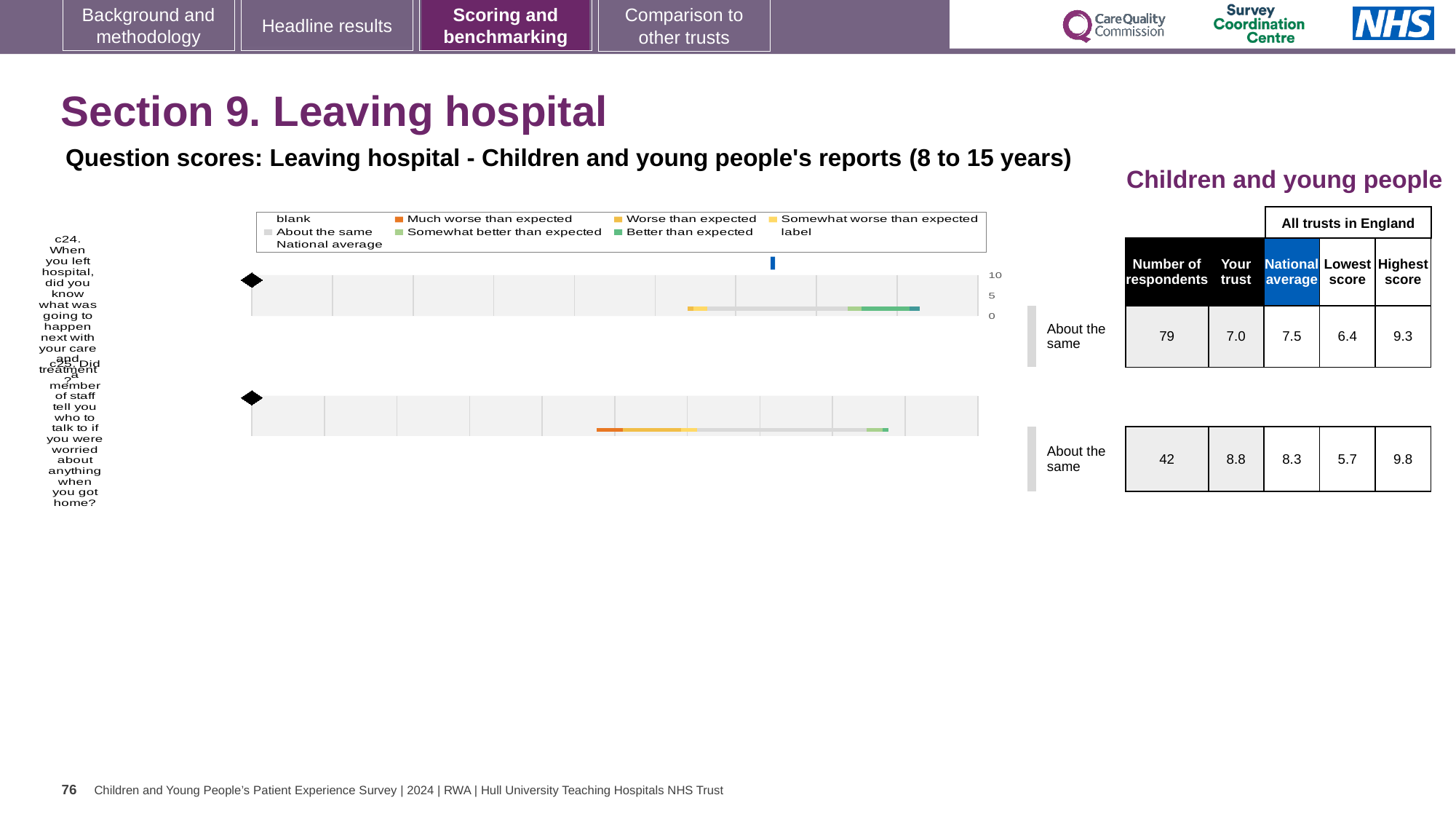
What kind of chart is used to show the question scores for c24 and c25? bar chart Which question has the higher 'Your trust' score, c24 or c25? c25 How many entries does the chart legend list? 9 What is the difference between the highest and lowest trust scores for question c25? 4.1 What benchmark category is shown for question c24? About the same How many respondents answered question c24? 79 For question c25, which is higher: the 'Your trust' score or the national average? Your trust What is the difference between the national average and the 'Your trust' score for question c24? 0.5 What is the national average score for question c25 (did a member of staff tell you who to talk to if you were worried when you got home)? 8.3 How many questions (c24 and c25) are plotted in the chart? 2 What is the 'Your trust' score for question c24 (did you know what was going to happen next with your care and treatment)? 7.0 What is the highest score among all trusts in England for question c25? 9.8